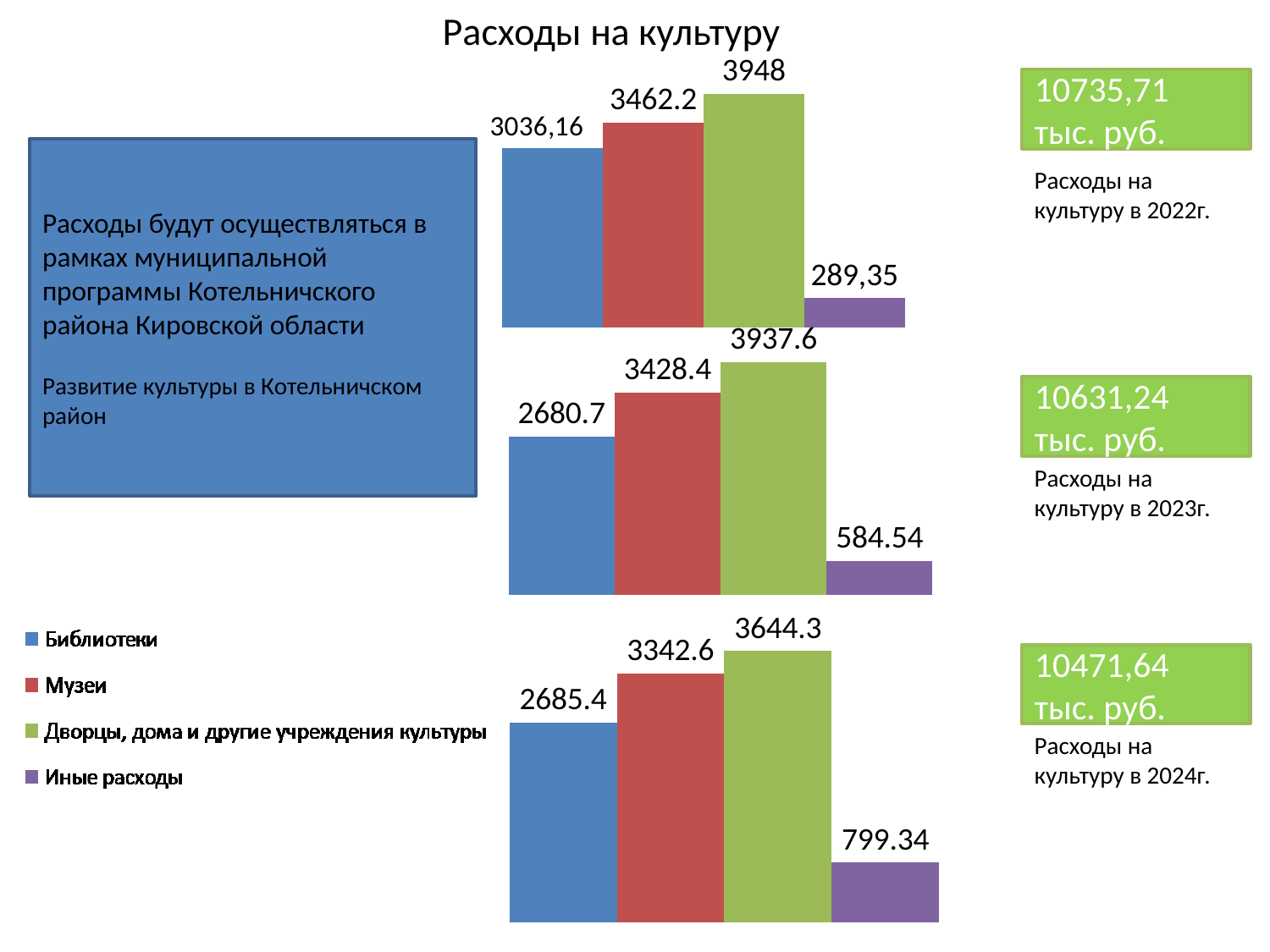
In the middle chart (expenses in 2023), which is larger: the value for Музеи or the value for Библиотеки? Музеи In the middle chart (expenses in 2023), what is the difference between the values for Музеи and Библиотеки? 747.7 In the top chart (expenses in 2022), which category has the highest value? Дворцы, дома и другие учреждения культуры In the top chart (expenses in 2022), what is the value for Библиотеки? 3036,16 In the bottom chart (expenses in 2024), what is the value for Музеи? 3342.6 In the bottom chart (expenses in 2024), what is the difference between the values for Дворцы, дома и другие учреждения культуры and Музеи? 301.7 How many series does the legend list? 4 What type of chart is used on this slide? Bar chart Is the value for Иные расходы in the top chart (2022) larger or smaller than the value for Иные расходы in the bottom chart (2024)? smaller In the bottom chart (expenses in 2024), which category has the lowest value? Иные расходы In the middle chart (expenses in 2023), what is the value for Иные расходы? 584.54 How many bars does each of the three charts contain? 4